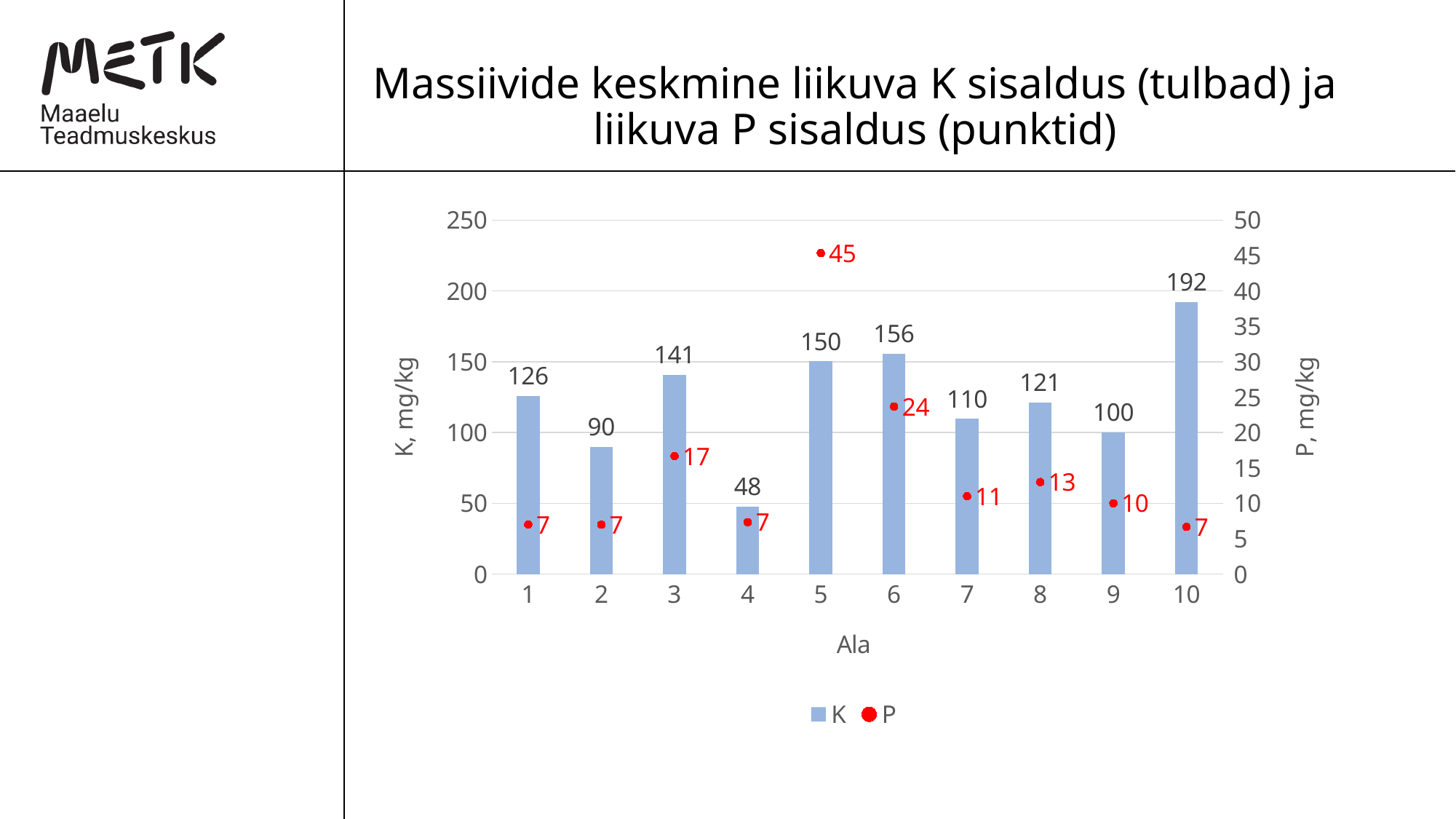
How many Ala categories are shown on the x axis? 10 What is the label of the left vertical axis? K, mg/kg Which Ala has the highest P value? 5 What is the P value (mg/kg) for Ala 5? 45 Which Ala has the highest K value? 10 What is the K value (mg/kg) for Ala 1? 126 What is the difference between the K values for Ala 6 and Ala 2? 66 What is the K value for Ala 10? 192 What is the P value for Ala 6? 24 Which has a larger K value, Ala 3 or Ala 8? Ala 3 Which Ala has the lowest K value? 4 How many series does the legend list? 2